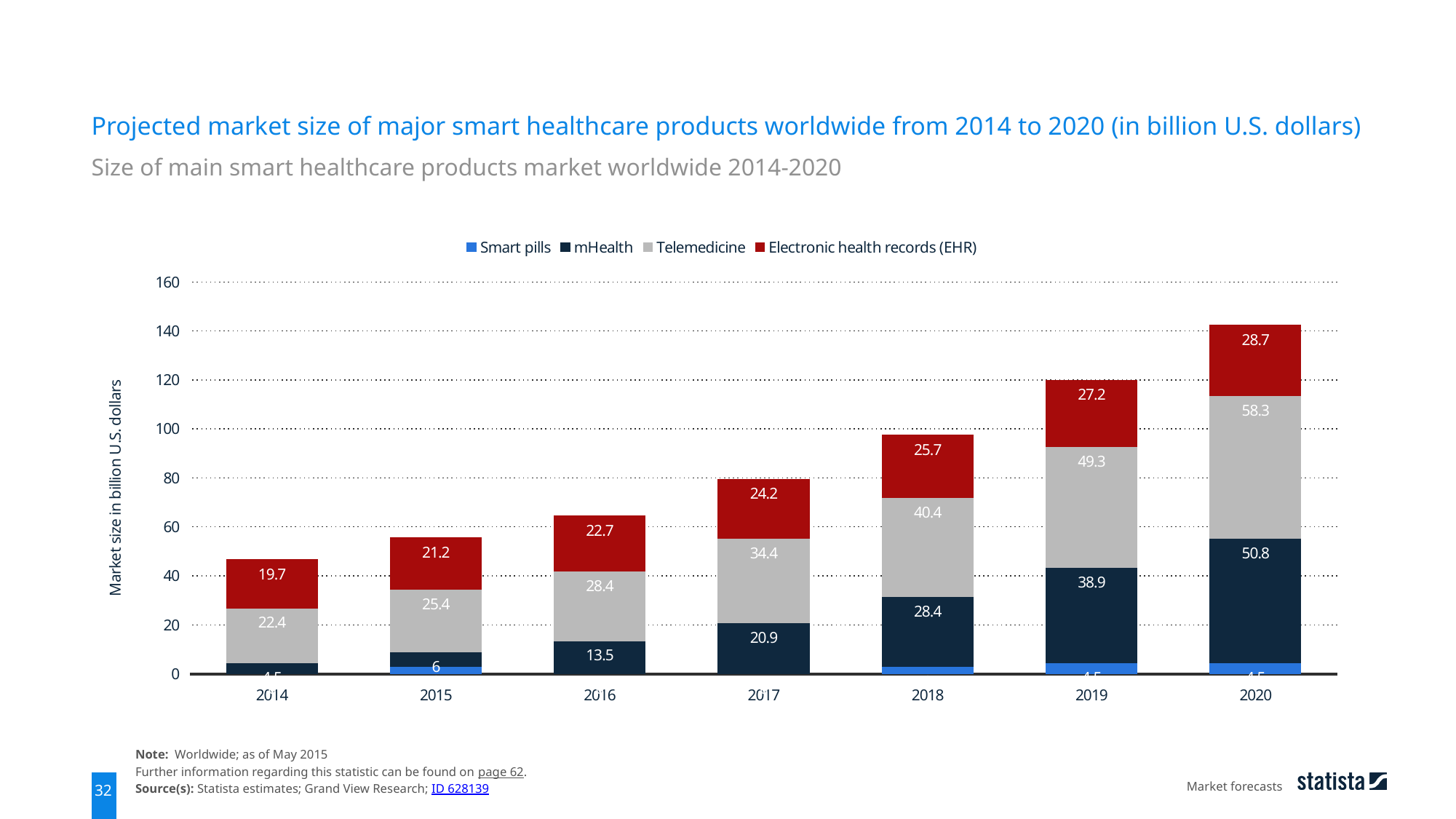
What kind of chart is shown on the slide? Stacked bar chart In 2018, which is larger: the mHealth value or the Electronic health records (EHR) value? mHealth By how much does the Telemedicine value in 2020 exceed the Telemedicine value in 2019? 9 Is the total height of the 2016 stacked bar greater or less than 60? greater What is the label on the y axis? Market size in billion U.S. dollars In which year is the Telemedicine value highest? 2020 Do the Electronic health records (EHR) values rise or fall from 2014 to 2020? Rise What is the Telemedicine value for 2018? 40.4 What is the projected market size for Electronic health records (EHR) in 2020? 28.7 How many series does the legend list? 4 What is the mHealth value for 2017? 20.9 How many years are shown on the x axis? 7